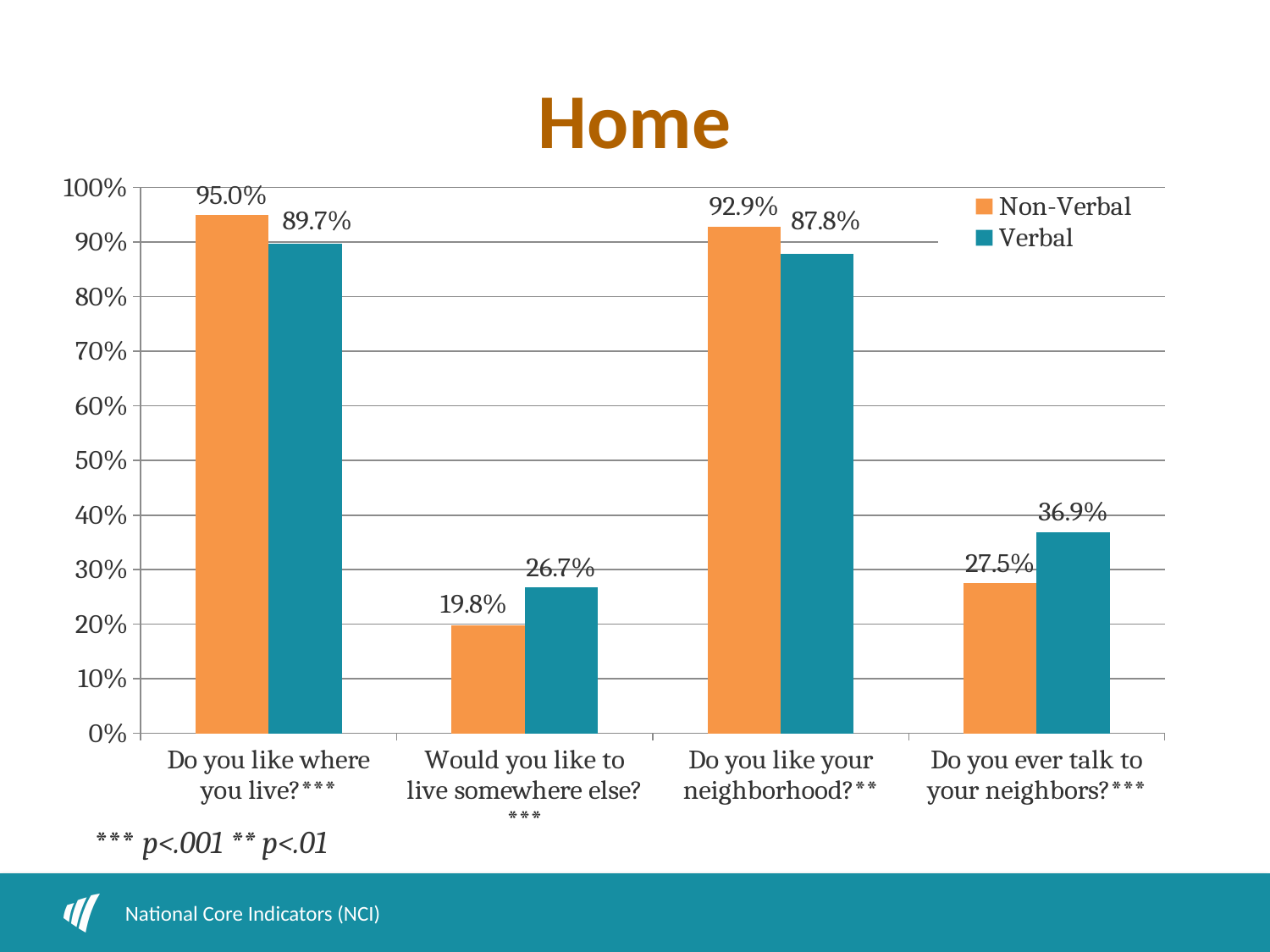
Which question has the highest Non-Verbal value? Do you like where you live? What is the Verbal value for "Do you ever talk to your neighbors?"? 36.9% Which colour represents the Verbal series? Teal How many questions (categories) are shown on the x axis? 4 For "Do you ever talk to your neighbors?", which is larger, the Non-Verbal or the Verbal value? Verbal What is the Verbal value for "Would you like to live somewhere else?"? 26.7% What kind of chart is shown on the slide? Bar chart Which question has the lowest Verbal value? Would you like to live somewhere else? What is the Non-Verbal value for "Do you like where you live?"? 95.0% Is the Non-Verbal value for "Would you like to live somewhere else?" greater or less than 20%? less What is the difference between the Non-Verbal and Verbal values for "Do you like your neighborhood?"? 5.1% How many series does the legend list? 2